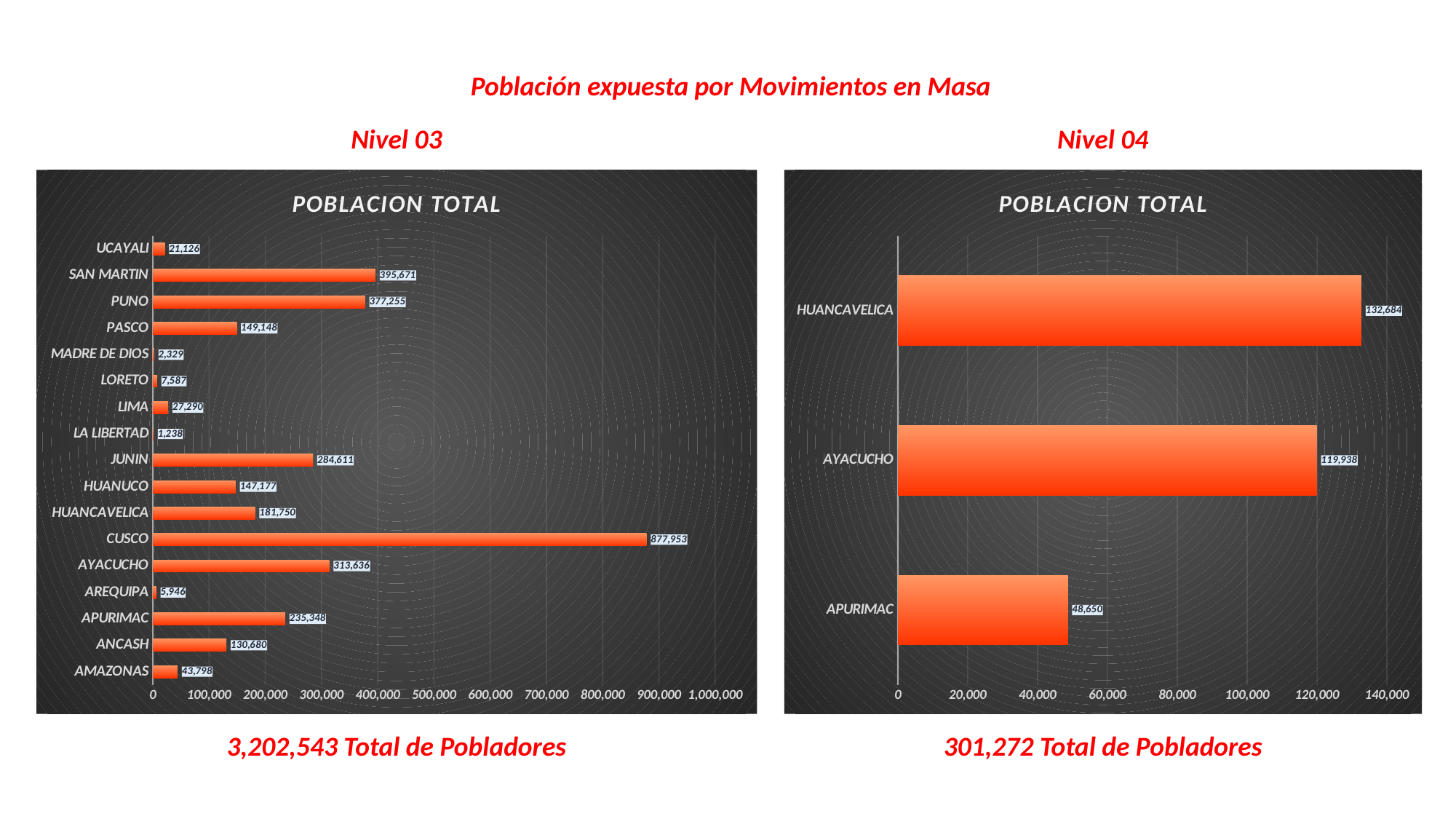
In the Nivel 03 chart on the left, which category has the lowest value? LA LIBERTAD In the Nivel 03 chart on the left, which category has the highest value? CUSCO How many categories are shown in the Nivel 03 chart on the left? 17 In the Nivel 03 chart on the left, what is the difference between CUSCO and SAN MARTIN? 482,282 In the Nivel 03 chart on the left, which is larger, PUNO or JUNIN? PUNO In the Nivel 04 chart on the right, which category has the lowest value? APURIMAC In the Nivel 03 chart on the left, what is the value for CUSCO? 877,953 What kind of chart is the Nivel 04 chart on the right? Bar chart In the Nivel 04 chart on the right, what is the difference between HUANCAVELICA and AYACUCHO? 12,746 In the Nivel 04 chart on the right, what is the value for AYACUCHO? 119,938 In the Nivel 03 chart on the left, what is the value for SAN MARTIN? 395,671 How many categories are shown in the Nivel 04 chart on the right? 3